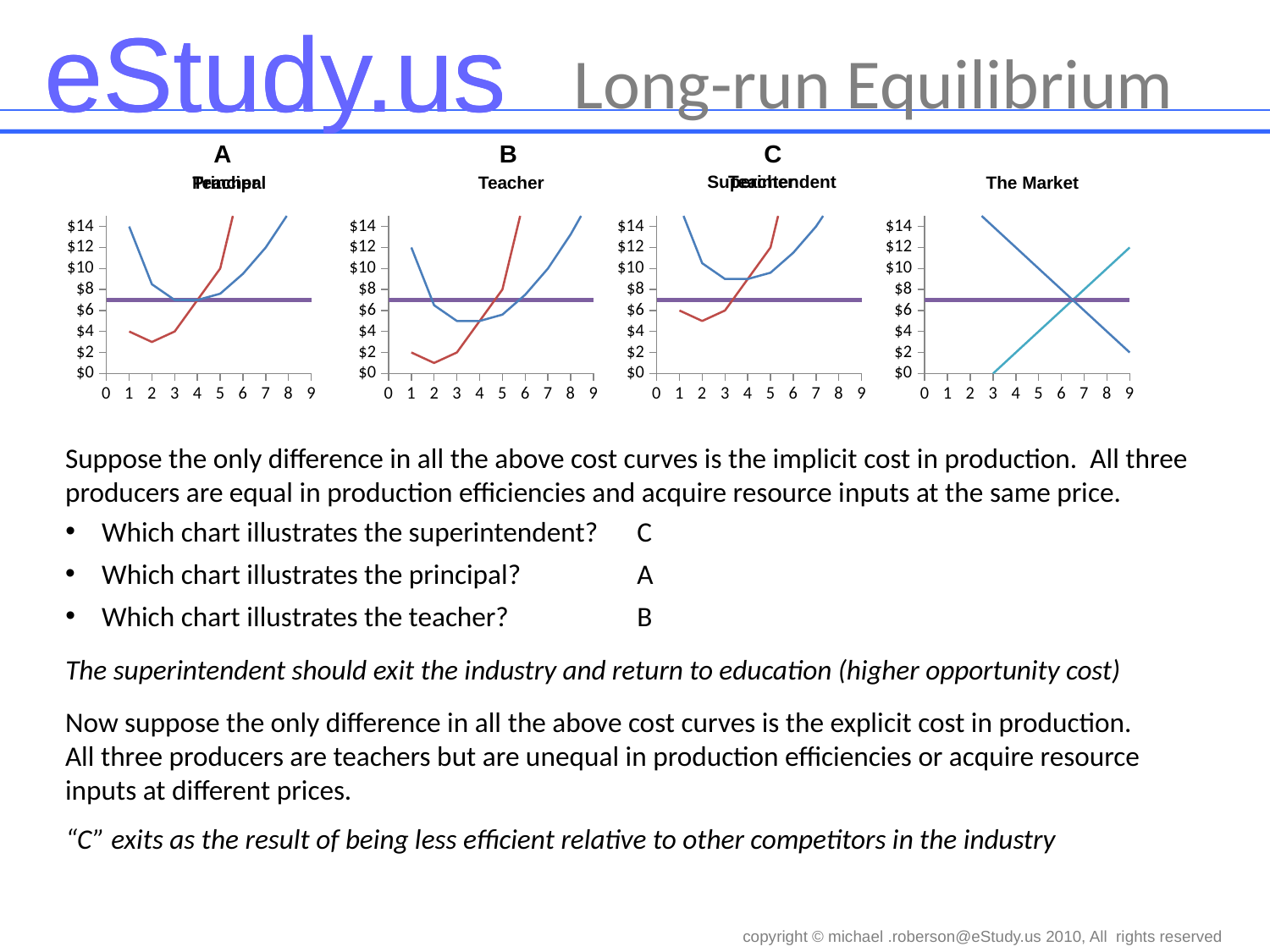
How many charts are shown on the slide? 4 In the chart titled 'The Market', does the dark blue line rise or fall as the x axis increases? fall In the chart titled 'The Market', is the value of the light blue line at x = 9 greater or less than $10? greater What kind of chart is the chart titled 'The Market'? line chart What is the title of the fourth (rightmost) chart? The Market In chart C, is the lowest point of the blue curve greater or less than $8? greater What is the highest value labelled on the vertical axis of chart A? $14 In the chart titled 'The Market', does the light blue line rise or fall as the x axis increases? rise In the chart titled 'The Market', is the value of the dark blue line at x = 9 greater or less than $4? less What is the title of chart B? Teacher